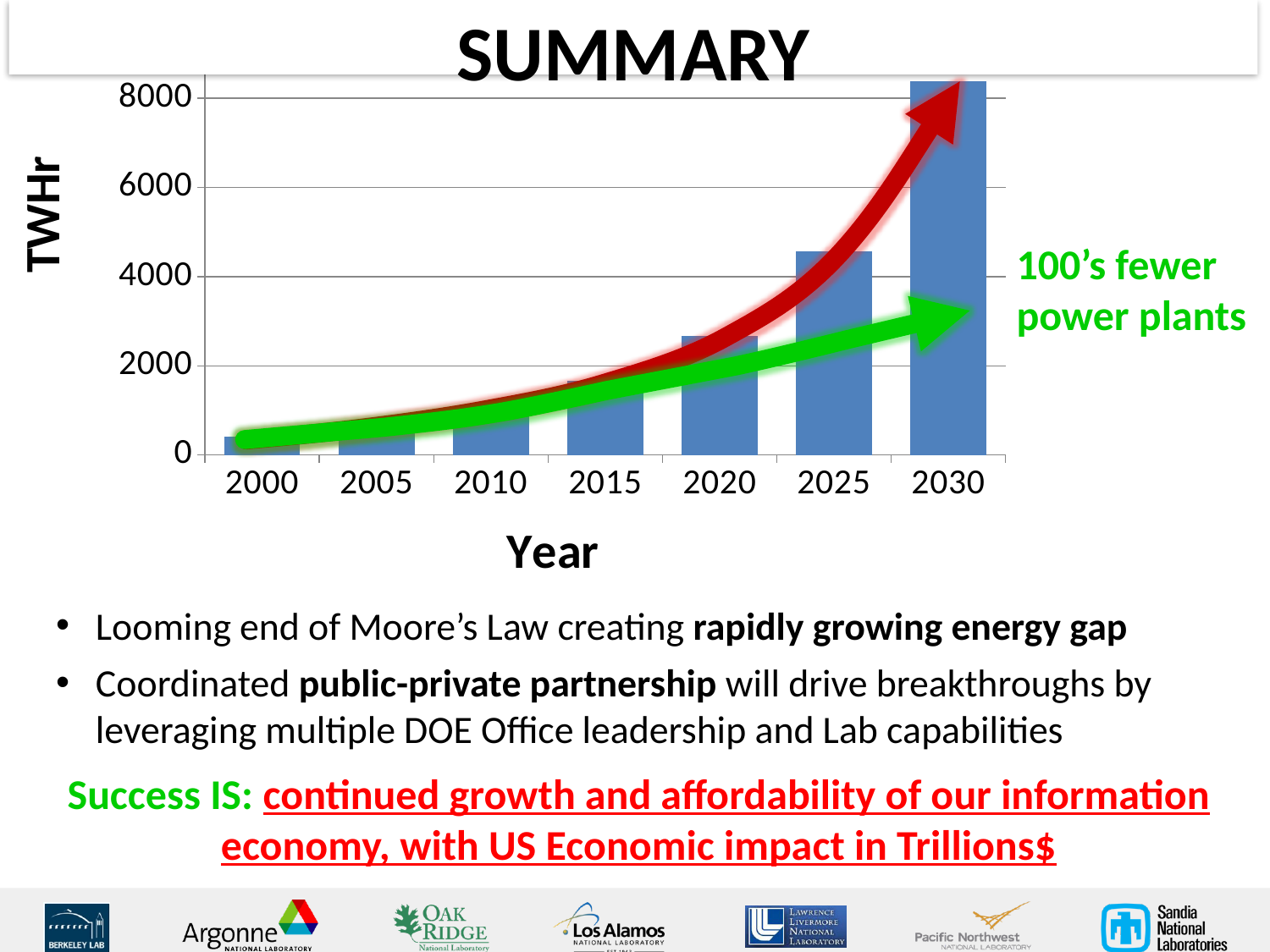
Which year has the larger bar, 2020 or 2025? 2025 What is the label on the y axis of the chart? TWHr How many years are plotted on the x axis of the chart? 7 Which year has the highest bar in the chart? 2030 Is the value for 2020 greater or less than 2000? greater Is the value for 2015 greater or less than 2000? less Is the value for 2030 greater or less than 8000? greater What kind of chart is shown on the slide? bar chart Which year has the lowest bar in the chart? 2000 What is the label on the x axis of the chart? Year Do the bar values rise or fall from 2000 to 2030? rise